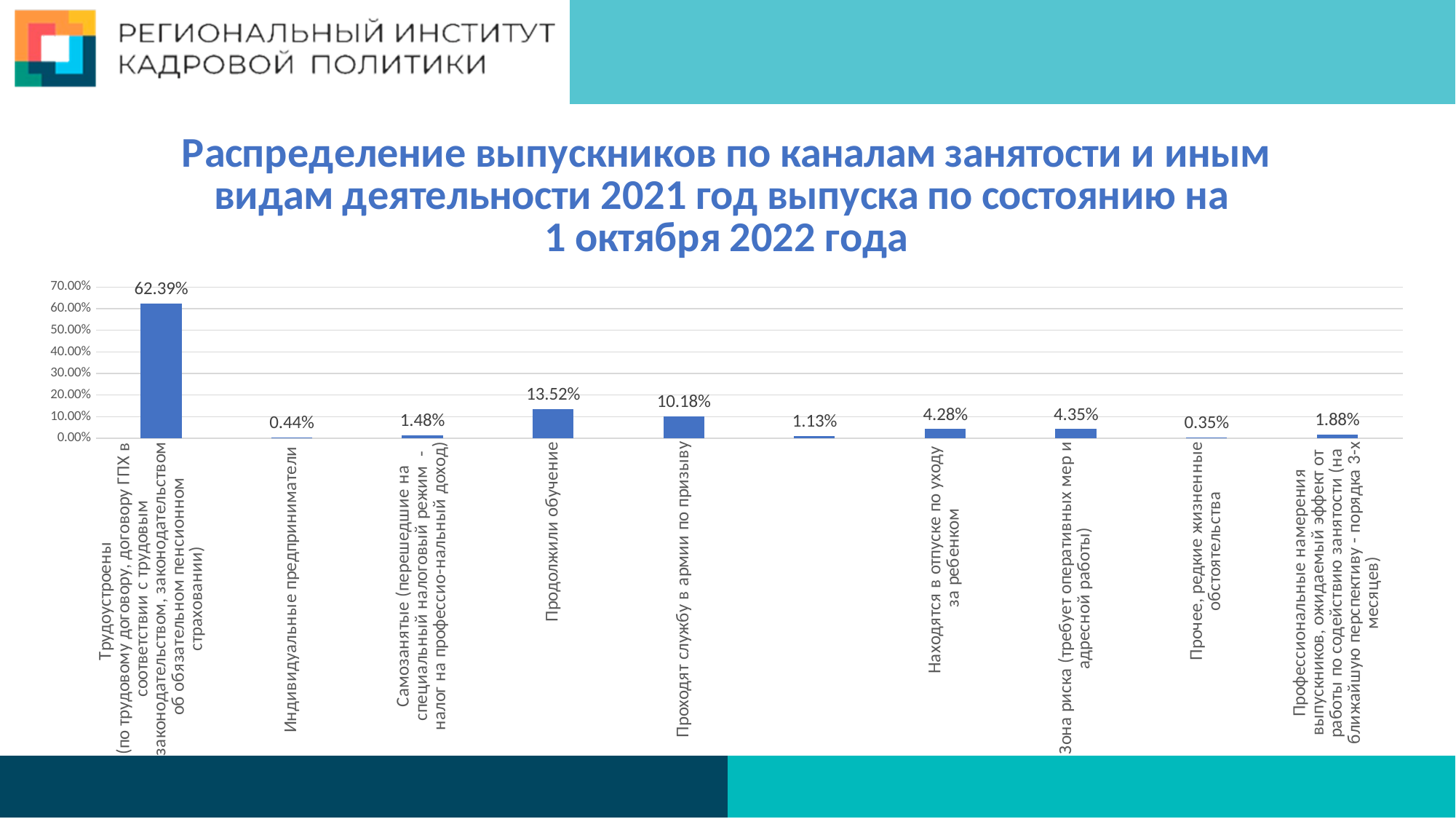
How many bars are plotted in the chart? 10 Which category has the lowest value? Прочее, редкие жизненные обстоятельства What is the value for "Продолжили обучение"? 13.52% What is the value for "Индивидуальные предприниматели"? 0.44% What is the value for "Проходят службу в армии по призыву"? 10.18% What is the difference between the values for "Продолжили обучение" and "Проходят службу в армии по призыву"? 3.34% What type of chart is shown on the slide? bar chart What is the value for "Трудоустроены"? 62.39% Which is larger, the value for "Самозанятые" or the value for "Профессиональные намерения выпускников"? Профессиональные намерения выпускников What is the value for "Зона риска"? 4.35% Is the value for "Трудоустроены" greater or less than 60.00%? greater Which category has the highest value? Трудоустроены